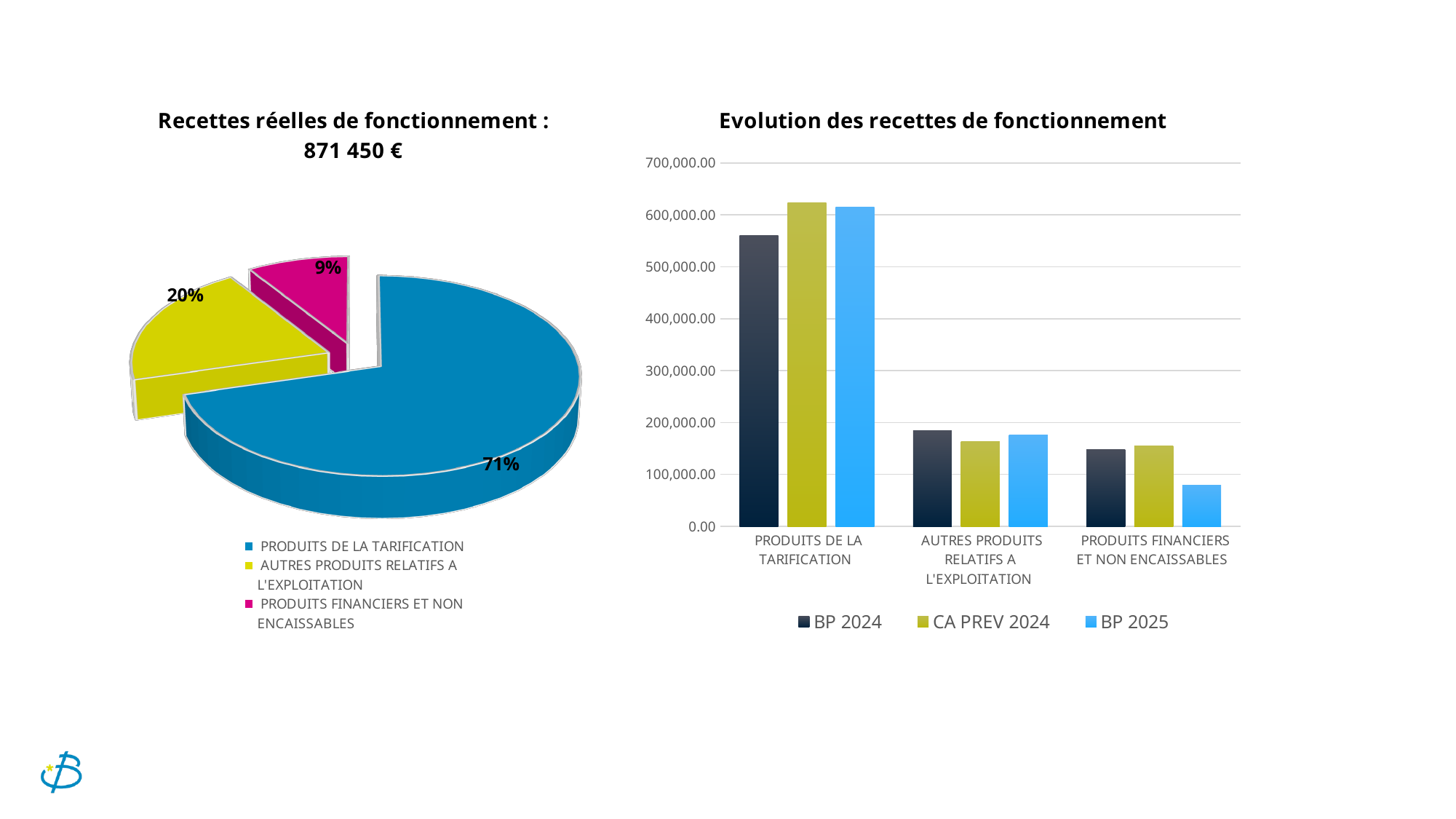
In the pie chart 'Recettes réelles de fonctionnement', what share does PRODUITS FINANCIERS ET NON ENCAISSABLES represent? 9% What total amount is shown in the title of the pie chart on the left? 871 450 € In the chart 'Evolution des recettes de fonctionnement', is the BP 2025 value for PRODUITS FINANCIERS ET NON ENCAISSABLES greater or less than 100,000.00? less In the chart 'Evolution des recettes de fonctionnement', is the BP 2025 value for PRODUITS DE LA TARIFICATION greater or less than 600,000.00? greater In the chart 'Evolution des recettes de fonctionnement', how many series does the legend list? 3 In the chart 'Evolution des recettes de fonctionnement', which category has the highest bars? PRODUITS DE LA TARIFICATION In the pie chart 'Recettes réelles de fonctionnement', what share does PRODUITS DE LA TARIFICATION represent? 71% In the pie chart 'Recettes réelles de fonctionnement', which category has the smallest slice? PRODUITS FINANCIERS ET NON ENCAISSABLES What kind of chart is 'Evolution des recettes de fonctionnement'? bar chart In the chart 'Evolution des recettes de fonctionnement', which is larger for PRODUITS DE LA TARIFICATION: BP 2024 or CA PREV 2024? CA PREV 2024 In the pie chart 'Recettes réelles de fonctionnement', what share does AUTRES PRODUITS RELATIFS A L'EXPLOITATION represent? 20% In the pie chart 'Recettes réelles de fonctionnement', how many slices are there? 3